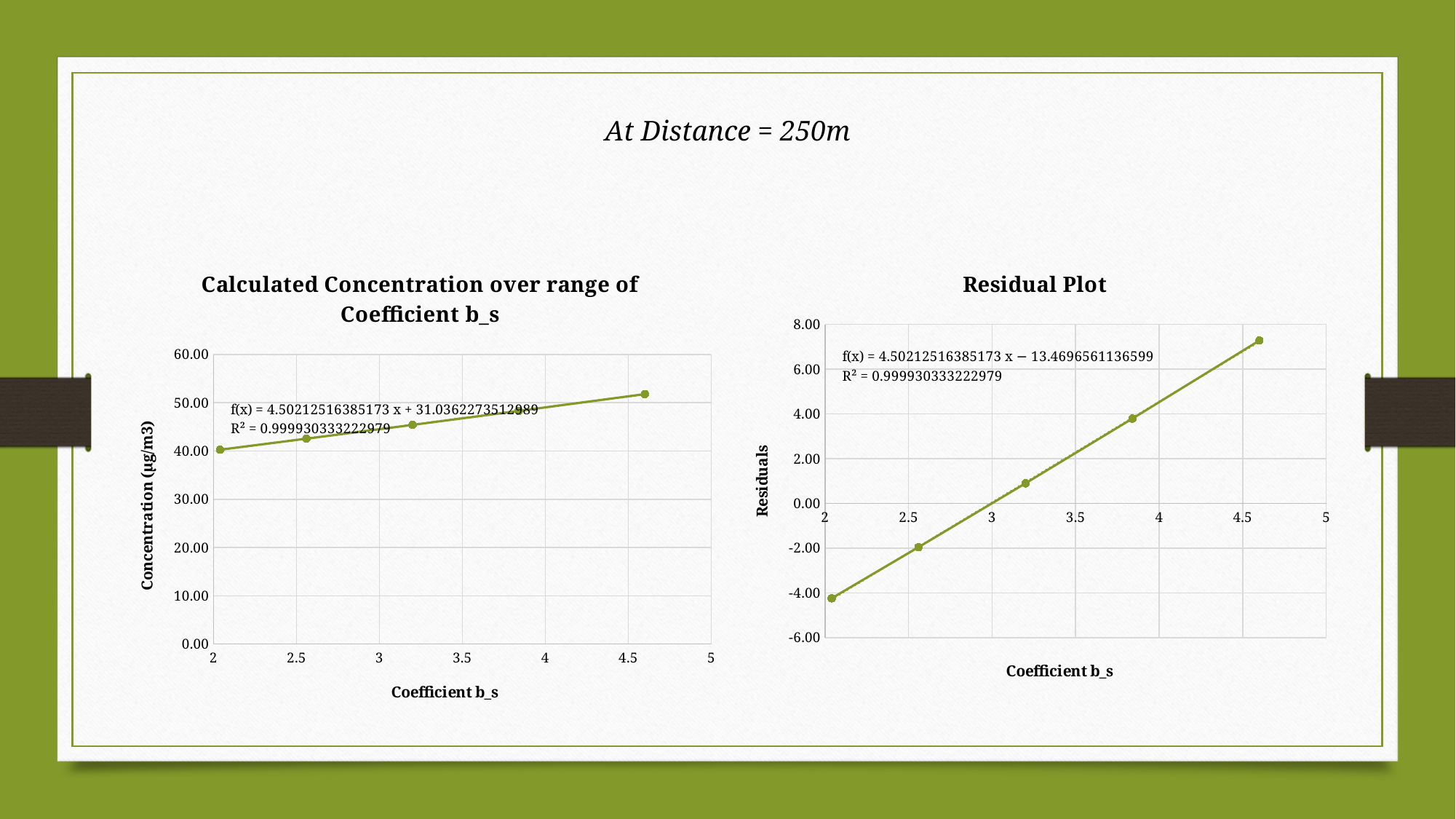
On the chart titled "Calculated Concentration over range of Coefficient b_s", how many data points are plotted? 5 What is the x-axis label of the "Residual Plot" chart? Coefficient b_s What is the y-axis label of the "Calculated Concentration over range of Coefficient b_s" chart? Concentration (µg/m3) On the "Residual Plot" chart, is the residual at the rightmost point (Coefficient b_s near 4.6) greater or less than 6.00? greater On the "Calculated Concentration over range of Coefficient b_s" chart, do the concentration values rise or fall as Coefficient b_s increases? rise On the "Calculated Concentration over range of Coefficient b_s" chart, is the concentration at the rightmost point (Coefficient b_s near 4.6) greater or less than 40.00? greater On the "Residual Plot" chart, is the residual at the leftmost point (Coefficient b_s near 2) greater or less than -2.00? less What R² value is printed on the "Residual Plot" chart? 0.999930333222979 What is the slope of the fitted line f(x) shown on the "Calculated Concentration over range of Coefficient b_s" chart? 4.50212516385173 On the "Residual Plot" chart, how many data points are plotted? 5 On the "Residual Plot" chart, do the residuals rise or fall as Coefficient b_s increases? rise